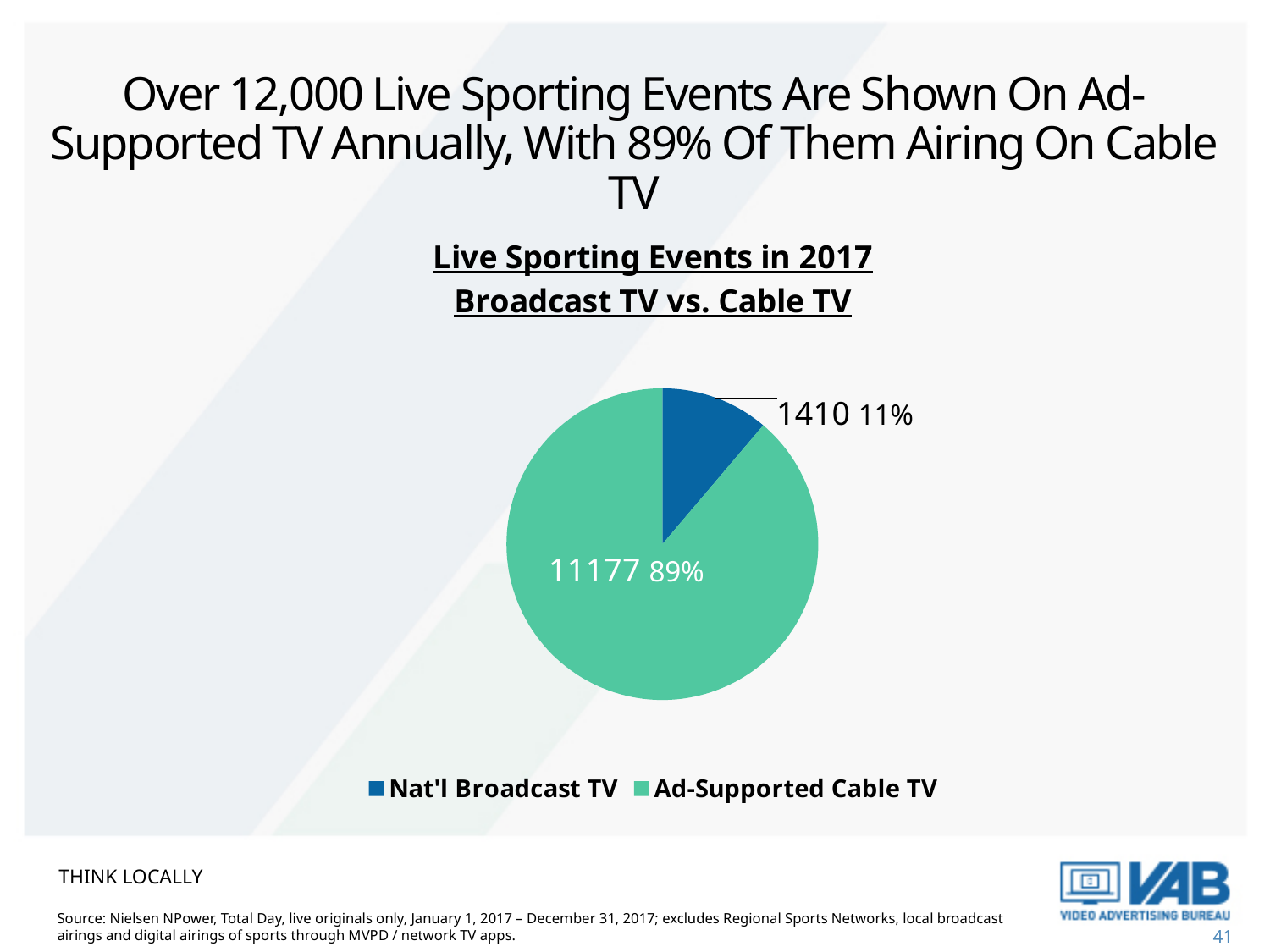
What colour is the Ad-Supported Cable TV slice in the pie chart? green What share of live sporting events aired on Ad-Supported Cable TV? 89% Which category has the smallest slice of the pie? Nat'l Broadcast TV How many live sporting events aired on Nat'l Broadcast TV in 2017? 1410 How many categories does the pie chart show? 2 How many live sporting events aired on Ad-Supported Cable TV in 2017? 11177 Which category has the largest slice of the pie? Ad-Supported Cable TV Which had more live sporting events in 2017, Nat'l Broadcast TV or Ad-Supported Cable TV? Ad-Supported Cable TV What kind of chart is shown on the slide? pie chart What is the total number of live sporting events shown across both slices of the pie? 12587 What is the difference in the number of live sporting events between Ad-Supported Cable TV and Nat'l Broadcast TV? 9767 What share of live sporting events aired on Nat'l Broadcast TV? 11%